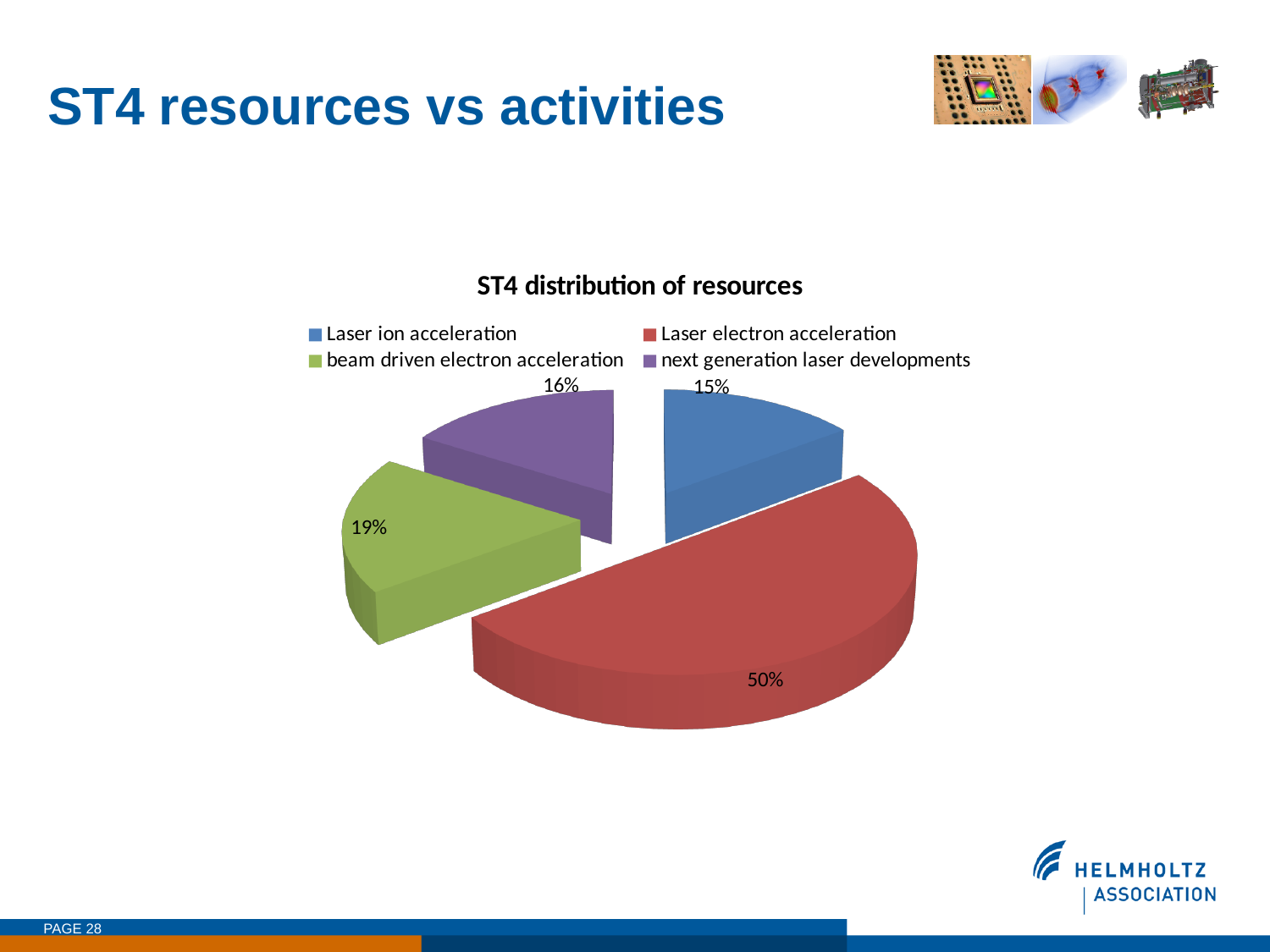
What share of resources goes to Laser ion acceleration? 15% What share of resources goes to Laser electron acceleration? 50% Which activity receives the smallest share of resources? Laser ion acceleration What is the title of the chart? ST4 distribution of resources Which colour represents beam driven electron acceleration in the chart? Green How many entries does the legend list? 4 Which activity receives the largest share of resources? Laser electron acceleration What share of resources goes to next generation laser developments? 16% What is the difference in percentage points between Laser electron acceleration and beam driven electron acceleration? 31 What type of chart is shown on the slide? Pie chart How many slices does the pie chart have? 4